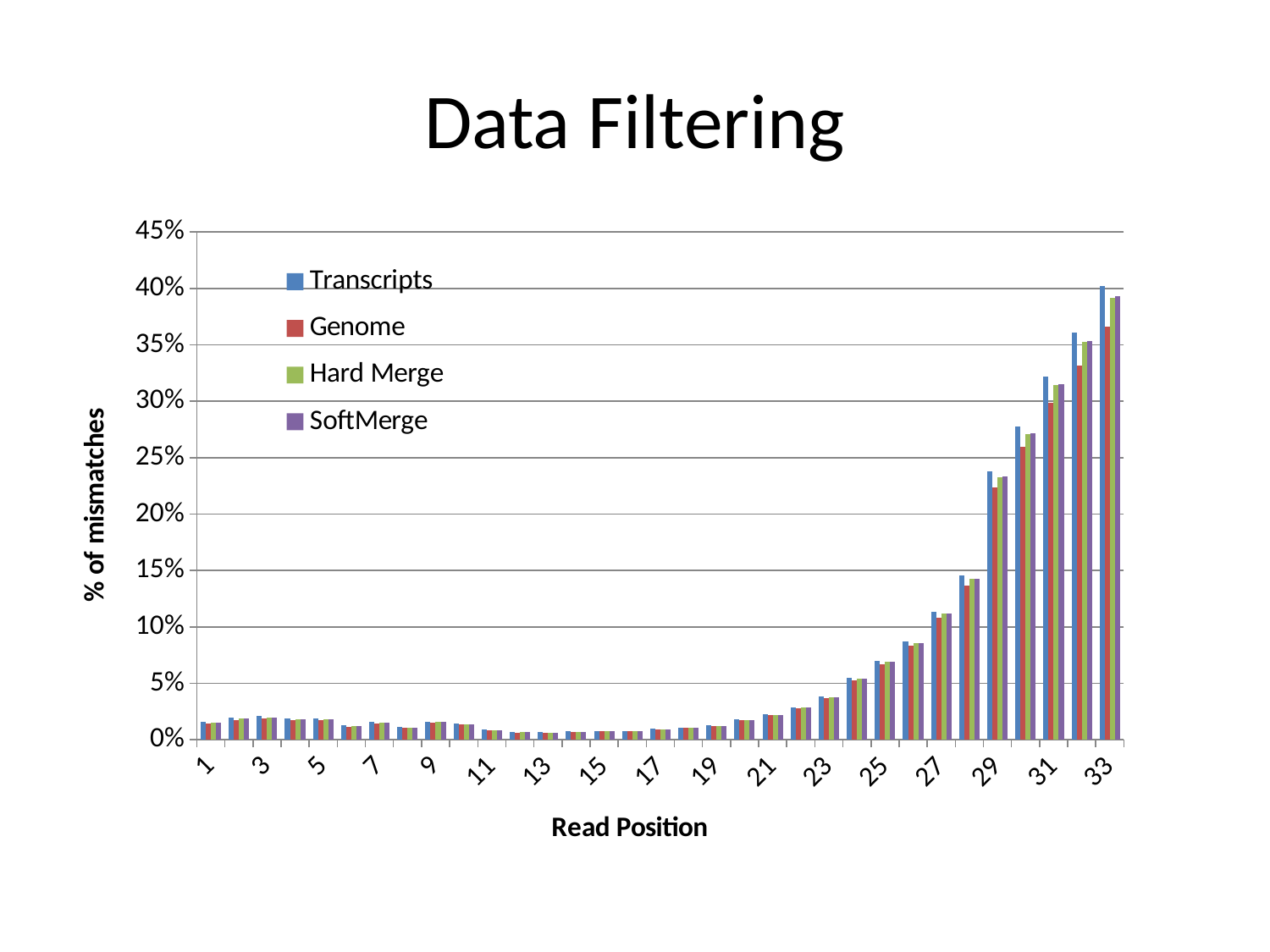
At read position 33, which is larger: the Transcripts value or the Genome value? Transcripts What is the title of the chart? Data Filtering At which read position is the Transcripts value highest? 33 Is the Transcripts value at read position 29 greater or less than 20%? greater At read position 29, which is larger: the Transcripts value or the Genome value? Transcripts Do the values rise or fall from read position 21 to read position 33? rise What kind of chart is shown on the slide? bar chart Is the Transcripts value at read position 25 greater or less than 5%? greater How many series does the legend list? 4 What is the label of the vertical axis? % of mismatches Is the Genome value at read position 13 greater or less than 5%? less